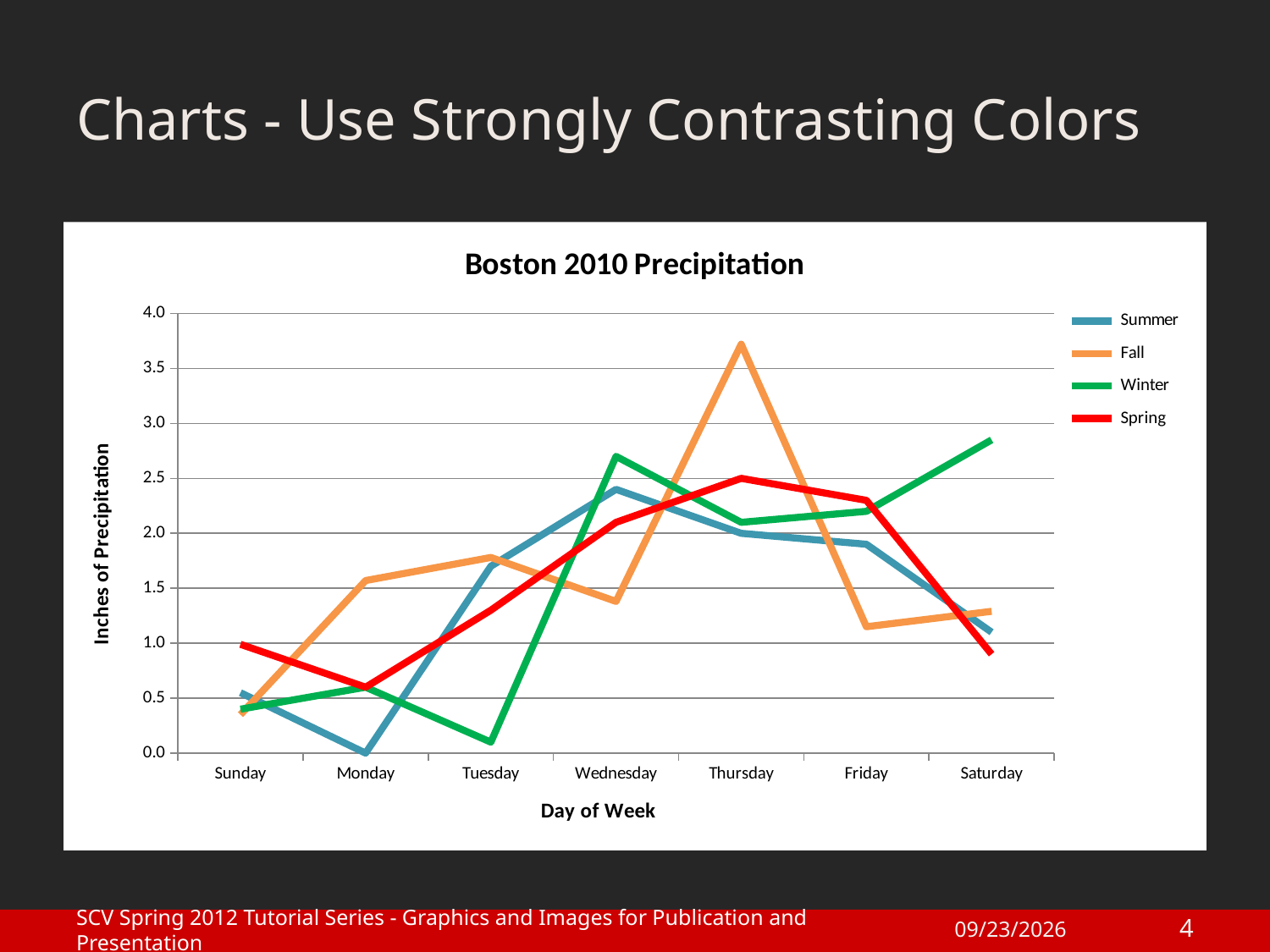
Does the Winter series rise or fall from Friday to Saturday? rise On which day does the Fall series reach its highest value? Thursday Is the Fall value on Thursday greater or less than 3.5? greater On Saturday, which series has the higher value, Winter or Spring? Winter What kind of chart is shown on the slide? line chart On which day does the Summer series reach its lowest value? Monday What is the title of the chart? Boston 2010 Precipitation What is the Summer value on Monday? 0.0 Is the Winter value on Tuesday greater or less than 0.5? less How many series does the legend list? 4 What is the label of the vertical axis? Inches of Precipitation How many days of the week are plotted along the x axis? 7